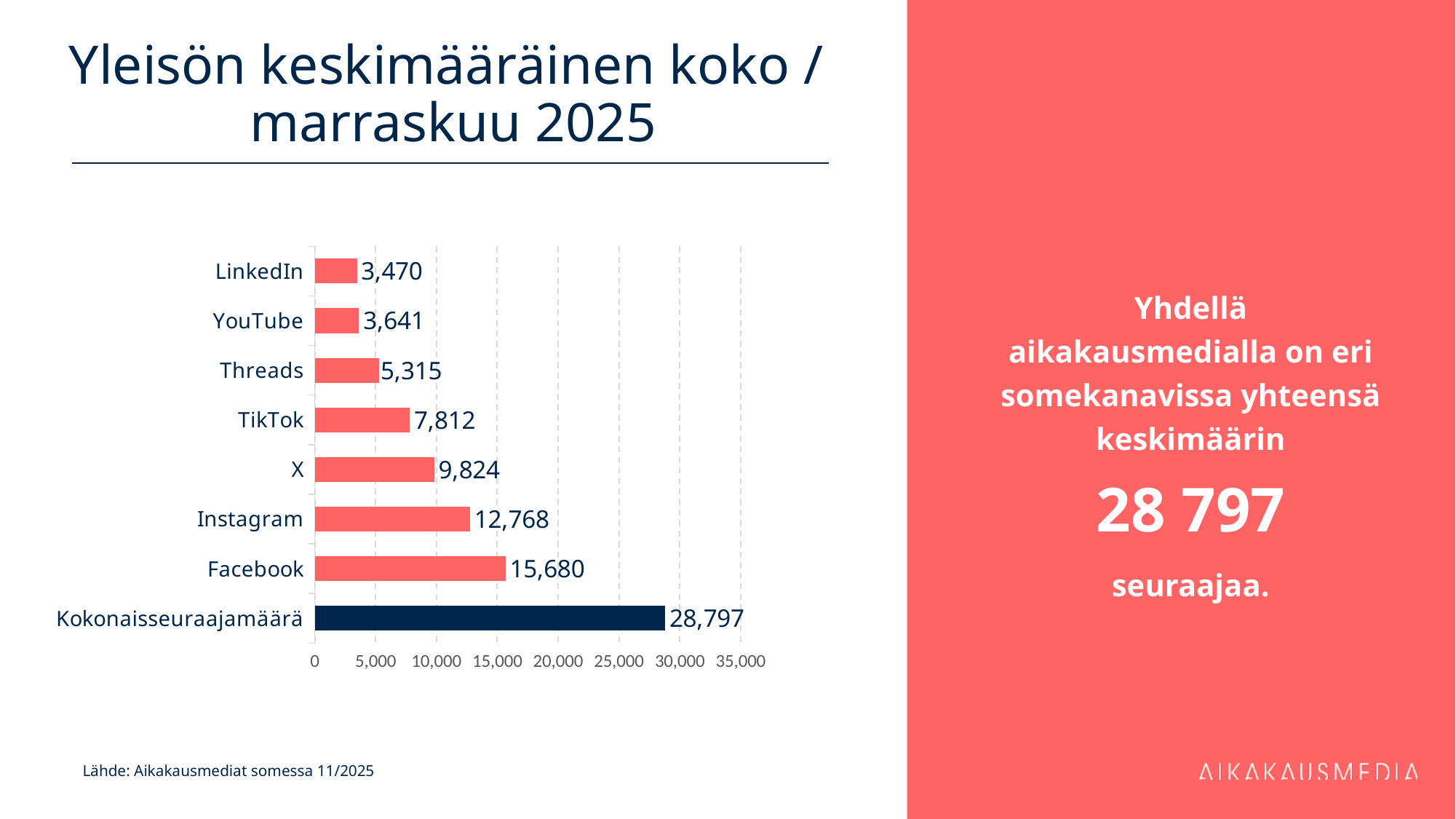
Which category has the lowest value? LinkedIn What is the difference between the values for X and Threads? 4,509 What is the value for Kokonaisseuraajamäärä? 28,797 What is the value for Facebook? 15,680 What kind of chart is shown on the slide? Bar chart Is the value for Instagram greater or less than 10,000? greater What is the value for TikTok? 7,812 What is the difference between the values for Facebook and Instagram? 2,912 Which category has the highest value? Kokonaisseuraajamäärä How many categories are shown in the chart? 8 Which is larger, the value for YouTube or the value for LinkedIn? YouTube What is the title of the slide containing the chart? Yleisön keskimääräinen koko / marraskuu 2025